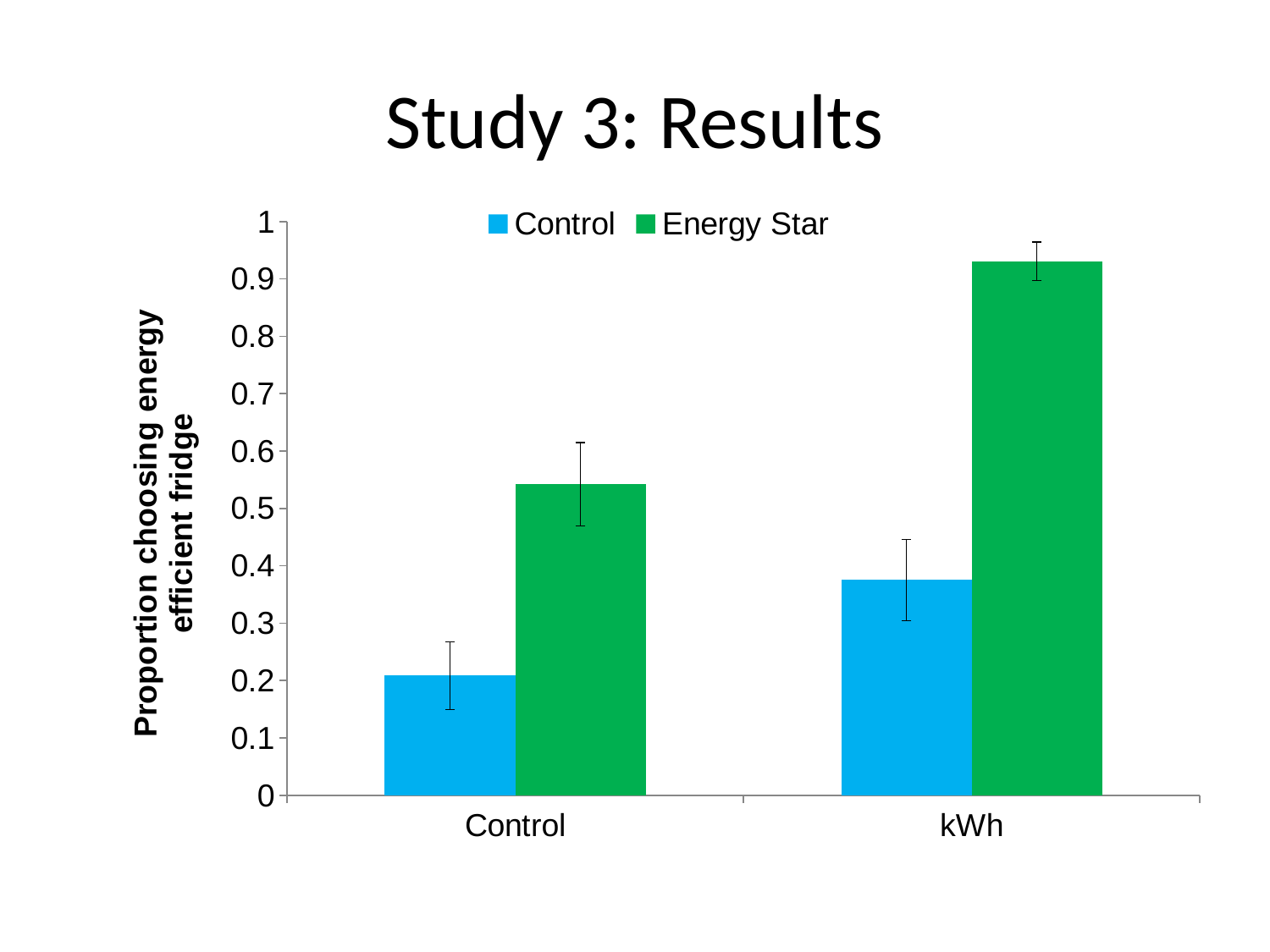
What is the label of the y axis? Proportion choosing energy efficient fridge Is the Control value for the Control category greater or less than 0.3? less How many categories are shown on the x axis? 2 Which series and category combination has the lowest bar? Control in Control Is the Energy Star value for kWh greater or less than 0.9? greater In the kWh category, which series has the larger value, Control or Energy Star? Energy Star Which series and category combination has the highest bar? Energy Star in kWh Is the Energy Star value for the Control category greater or less than 0.5? greater For the Control series, which category has the larger value, Control or kWh? kWh How many series does the legend list? 2 What kind of chart is shown on the slide? bar chart